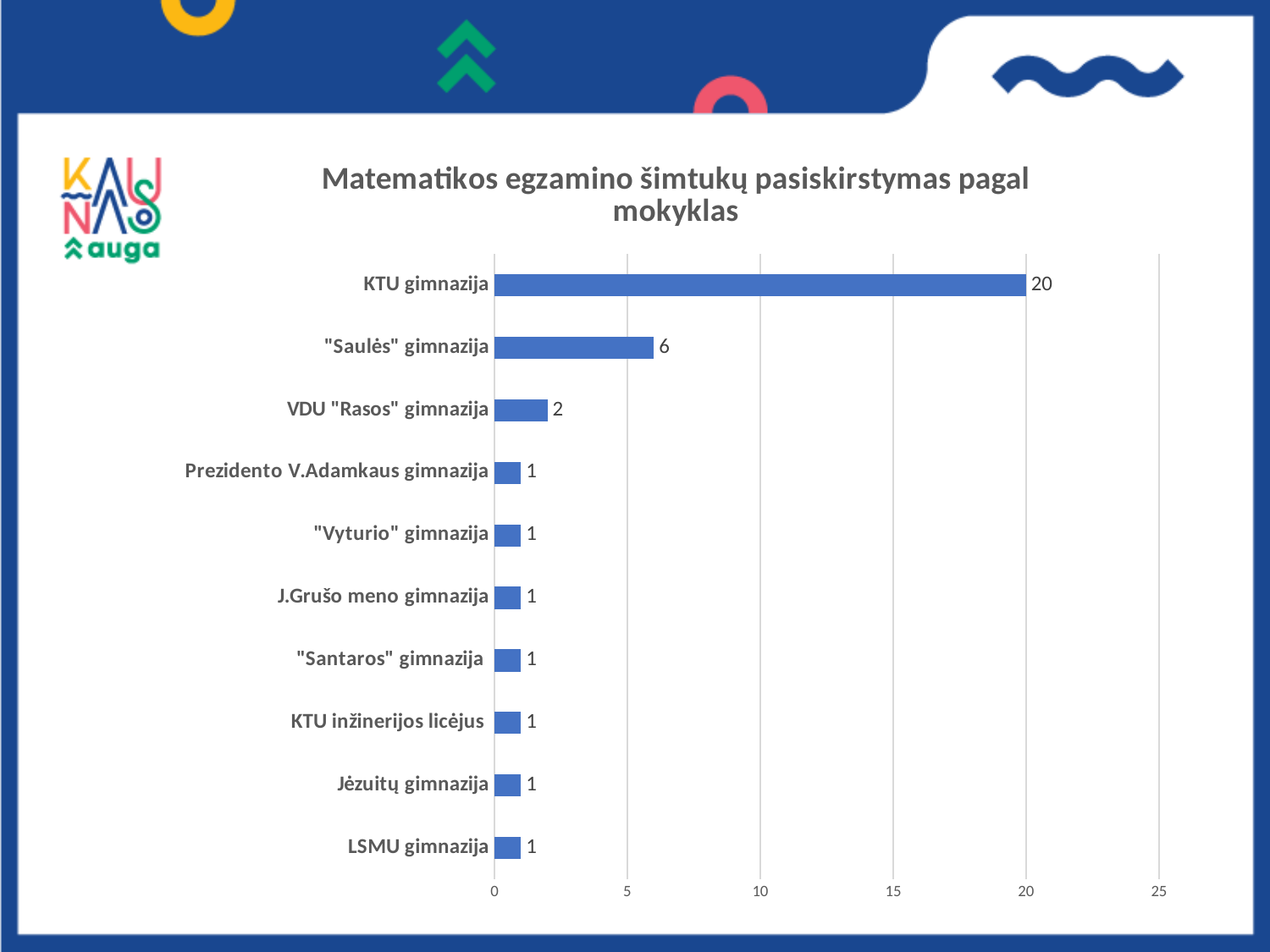
What is the value for Jėzuitų gimnazija? 1 What is the difference between the values for "Saulės" gimnazija and VDU "Rasos" gimnazija? 4 Which is larger, the value for "Saulės" gimnazija or VDU "Rasos" gimnazija? "Saulės" gimnazija What is the title of the chart? Matematikos egzamino šimtukų pasiskirstymas pagal mokyklas What is the value for VDU "Rasos" gimnazija? 2 What is the value for "Saulės" gimnazija? 6 What is the value for KTU gimnazija? 20 Is the value for KTU gimnazija greater or less than 15? greater Which school has the highest value? KTU gimnazija How many schools are shown in the chart? 10 What is the difference between the values for KTU gimnazija and "Saulės" gimnazija? 14 What kind of chart is shown on the slide? bar chart